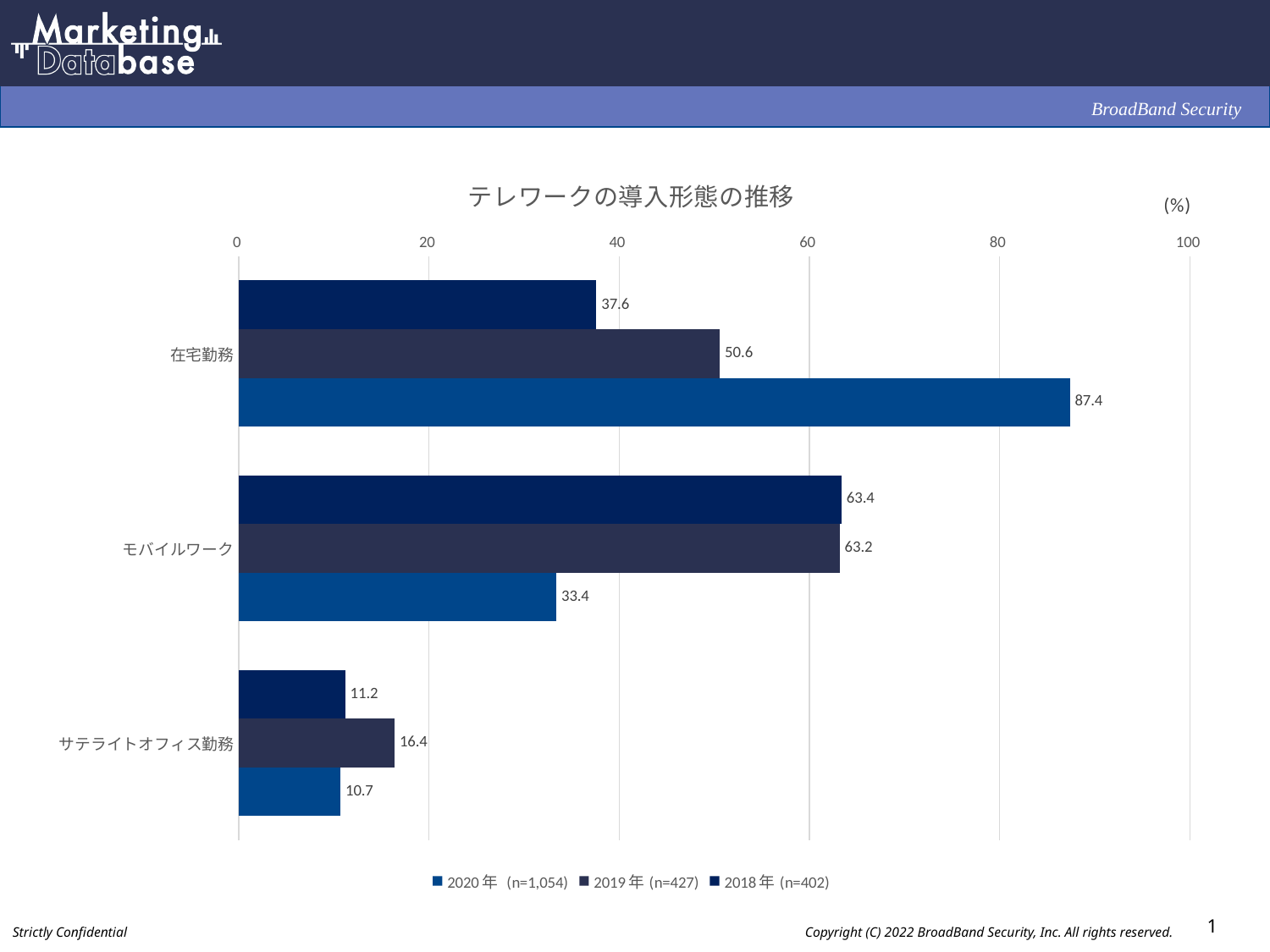
Is the 2019年 value for 在宅勤務 greater or less than 40? greater How many categories are shown on the chart? 3 What is the title of the chart? テレワークの導入形態の推移 What kind of chart is shown on the slide? bar chart What is the value for 在宅勤務 in the 2020年 series? 87.4 What is the value for サテライトオフィス勤務 in the 2018年 series? 11.2 What is the value for モバイルワーク in the 2019年 series? 63.2 Which is larger for モバイルワーク: the 2019年 value or the 2020年 value? 2019年 Which category has the lowest value in the 2019年 series? サテライトオフィス勤務 Which category has the highest value in the 2020年 series? 在宅勤務 What is the difference between the 2020年 and 2018年 values for 在宅勤務? 49.8 How many series does the legend list? 3